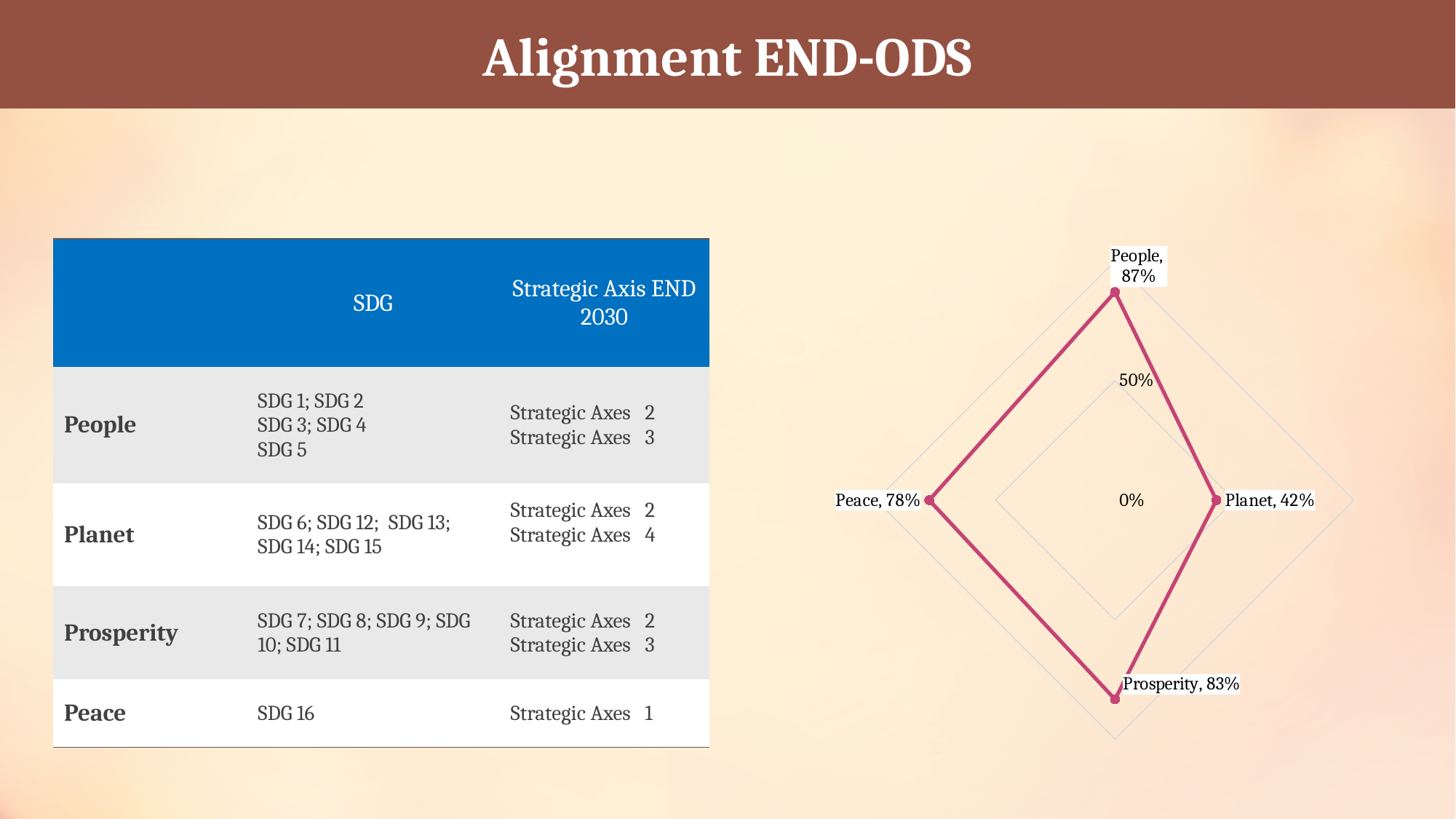
What is the value for Peace on the radar chart? 78% What is the difference between the values for Prosperity and Peace on the radar chart? 5% Which is larger on the radar chart, the value for Peace or the value for Planet? Peace What is the value for Planet on the radar chart? 42% What is the value for Prosperity on the radar chart? 83% How many categories are plotted on the radar chart? 4 Which category has the highest value on the radar chart? People Is the value for Planet on the radar chart greater or less than 50%? less What is the value for People on the radar chart? 87% What kind of chart is shown on the right of the slide? Radar chart Which category has the lowest value on the radar chart? Planet What is the difference between the values for People and Planet on the radar chart? 45%